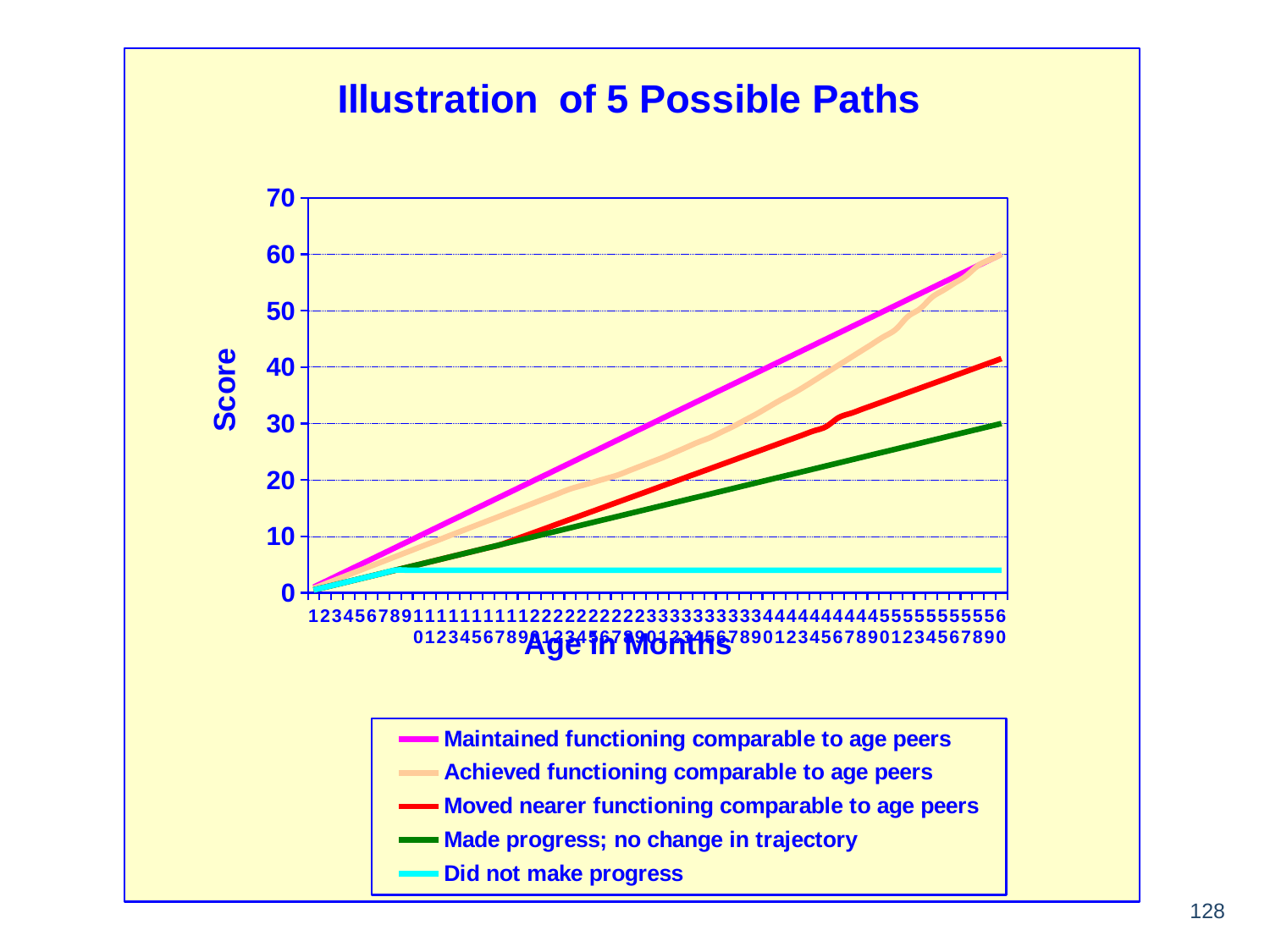
Is the value for 'Moved nearer functioning comparable to age peers' at 60 months greater or less than 30? greater Is the value for 'Made progress; no change in trajectory' at 60 months greater or less than 20? greater Is the value for 'Achieved functioning comparable to age peers' at 30 months greater or less than 40? less What kind of chart is shown on the slide? line chart Does the 'Maintained functioning comparable to age peers' line rise or fall as age in months increases? rise Which series has the lowest value at 60 months? Did not make progress Does the 'Did not make progress' line rise, fall, or stay flat as age in months increases? stay flat At 60 months, which is larger: 'Made progress; no change in trajectory' or 'Moved nearer functioning comparable to age peers'? Moved nearer functioning comparable to age peers What is the title of the chart? Illustration of 5 Possible Paths How many series does the legend list? 5 What is the label of the y axis? Score